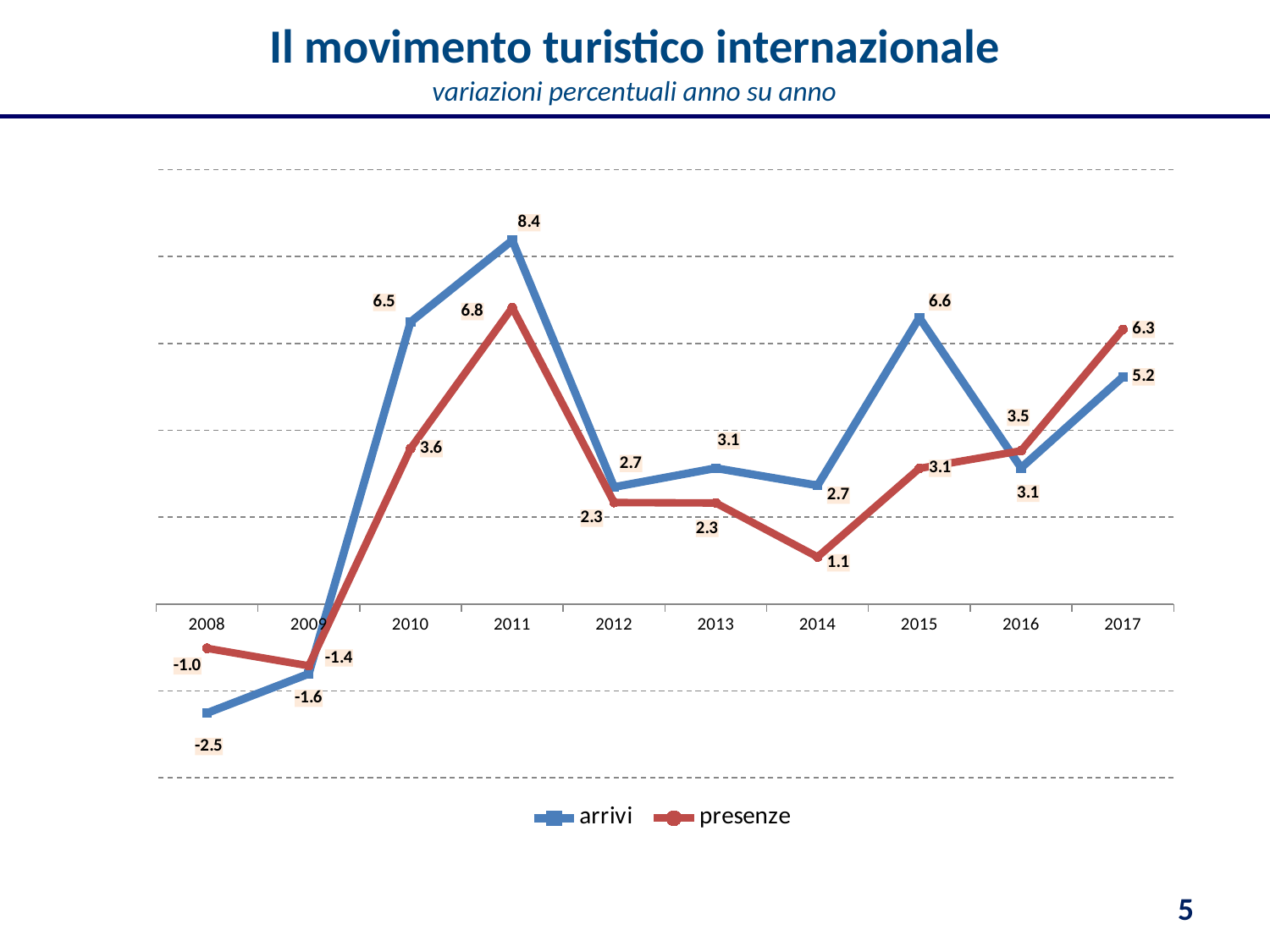
Does the presenze series rise or fall from 2014 to 2017? rise What is the difference between arrivi and presenze in 2010? 2.9 What type of chart is shown on the slide? line chart In which year does the arrivi series reach its highest value? 2011 How many series does the legend list? 2 In 2017, which series has the higher value, arrivi or presenze? presenze In which year does the presenze series have its lowest value? 2009 What is the value for presenze in 2014? 1.1 What is the value for arrivi in 2011? 8.4 What is the value for arrivi in 2008? -2.5 What is the subtitle of the chart shown on the slide? variazioni percentuali anno su anno How many years are plotted along the x axis? 10